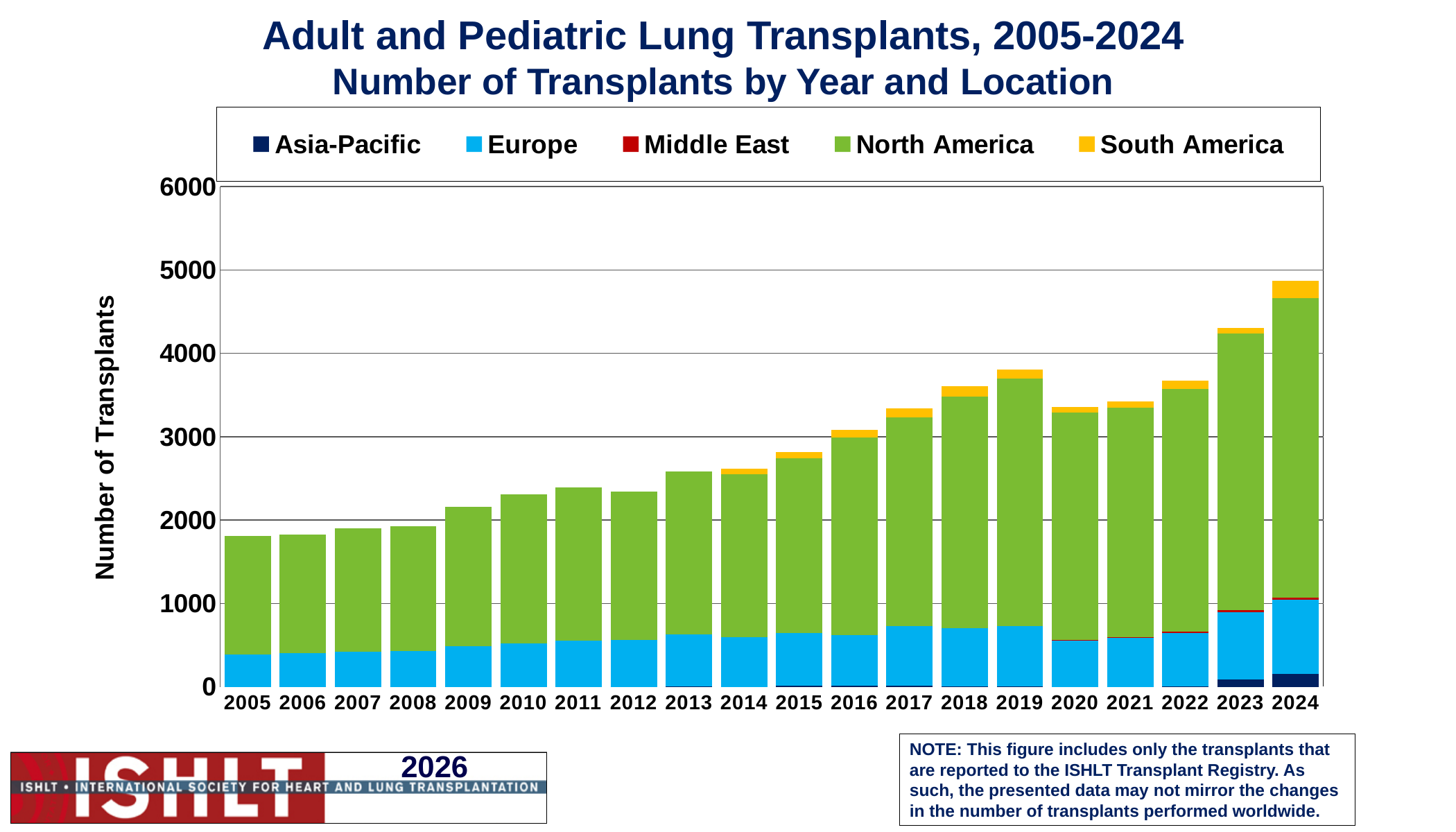
What kind of chart is shown on the slide? stacked bar chart Is the total number of transplants for 2024 greater or less than 4000? greater How many years are shown along the x axis? 20 Overall, do the total number of transplants rise or fall from 2005 to 2024? rise Which year has the larger total number of transplants, 2009 or 2013? 2013 Is the total number of transplants for 2013 greater or less than 3000? less Which year has the larger total number of transplants, 2020 or 2023? 2023 Is the total number of transplants for 2019 greater or less than 3000? greater Which year has the highest total number of transplants? 2024 What is the label on the y axis? Number of Transplants How many series does the legend list? 5